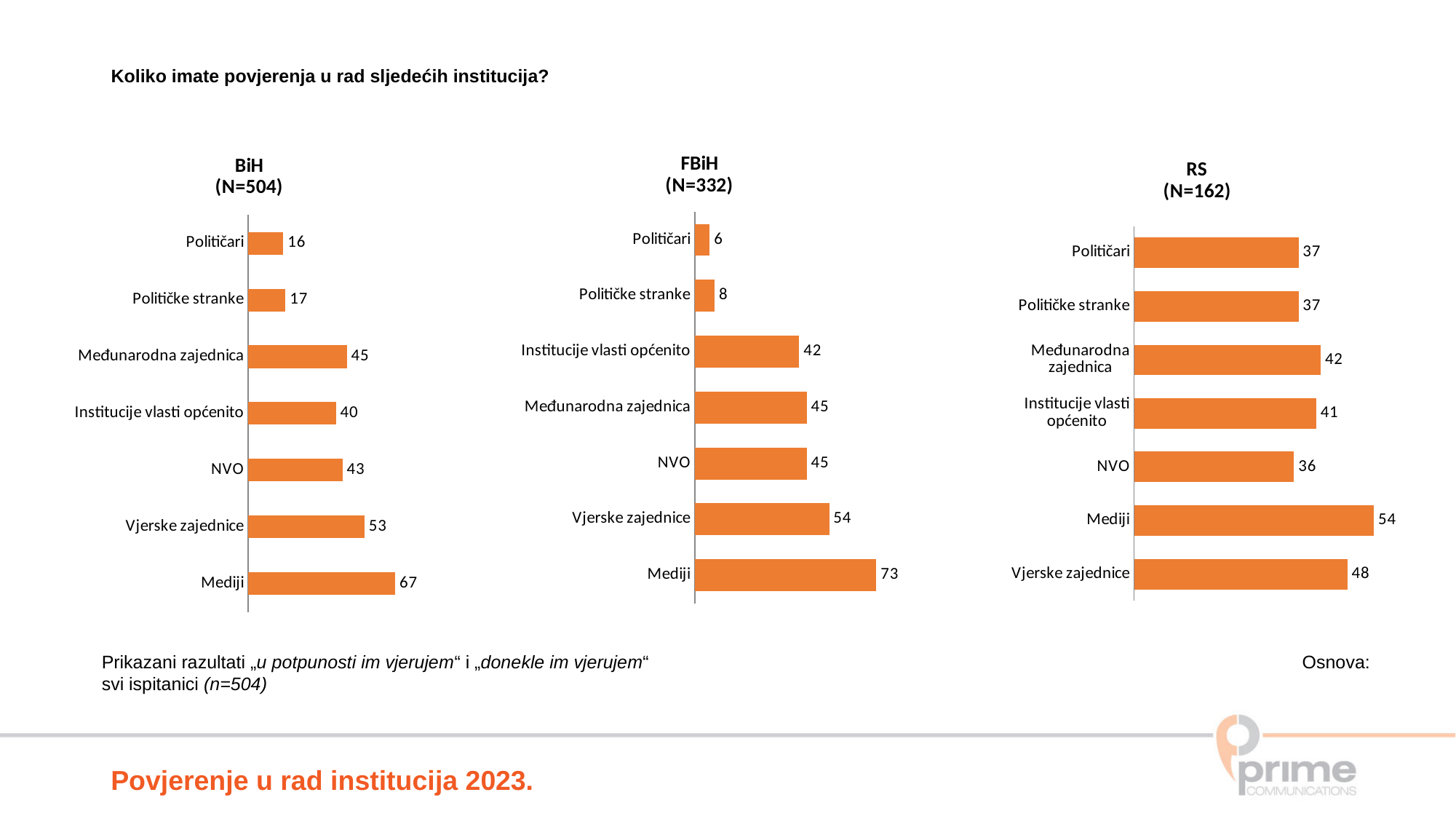
In the RS (N=162) chart, which is larger: the value for Mediji or the value for Vjerske zajednice? Mediji In the RS (N=162) chart, which category has the lowest value? NVO In the BiH (N=504) chart, which category has the lowest value? Političari In the FBiH (N=332) chart, what is the difference between the values for Mediji and Političari? 67 What type of chart is the BiH (N=504) chart? Bar chart In the BiH (N=504) chart, what is the value for Mediji? 67 In the FBiH (N=332) chart, which category has the highest value? Mediji How many categories are shown in the FBiH (N=332) chart? 7 What is the title of the RS chart on the right? RS (N=162) In the FBiH (N=332) chart, what is the value for Političari? 6 In the RS (N=162) chart, what is the value for Vjerske zajednice? 48 In the BiH (N=504) chart, what is the difference between the values for Mediji and Vjerske zajednice? 14